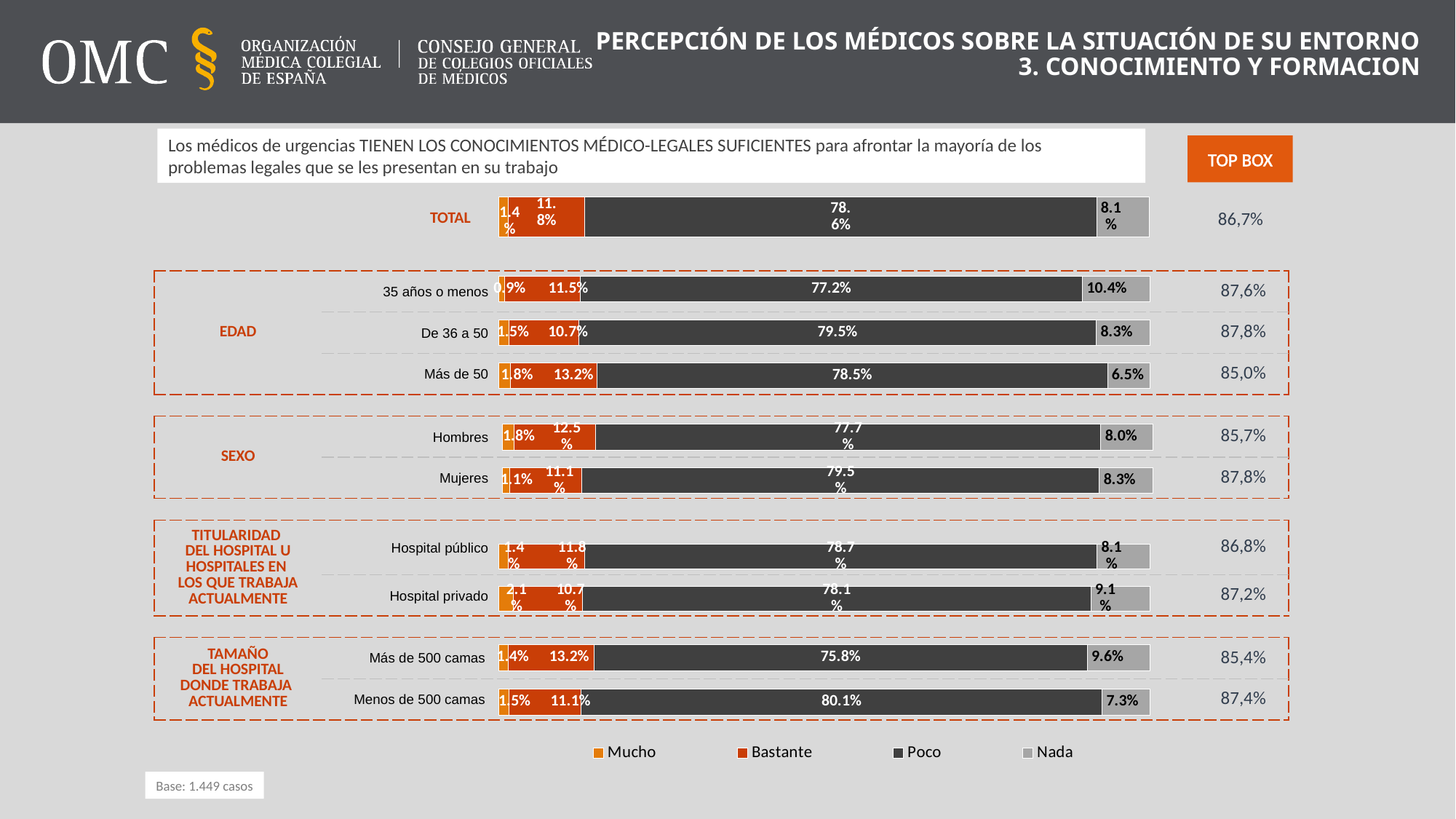
How many series does the legend list? 4 In the EDAD chart, what is the "Nada" value for "35 años o menos"? 10.4% What kind of chart is used on this slide? Stacked bar chart In the SEXO chart, what is the "Bastante" value for Hombres? 12.5% In the TITULARIDAD DEL HOSPITAL chart, what is the difference between the "Mucho" values for Hospital privado and Hospital público? 0.7% What is the TOP BOX value shown for the TOTAL bar? 86,7% In the TAMAÑO DEL HOSPITAL chart, what is the "Poco" value for "Menos de 500 camas"? 80.1% In the EDAD chart, which age group has the highest "Bastante" value? Más de 50 How many bars are shown in the EDAD chart? 3 In the TAMAÑO DEL HOSPITAL chart, which category has the lowest "Nada" value? Menos de 500 camas In the TOTAL bar, what percentage of doctors answered "Poco"? 78.6% In the SEXO chart, which has the larger "Poco" value, Hombres or Mujeres? Mujeres